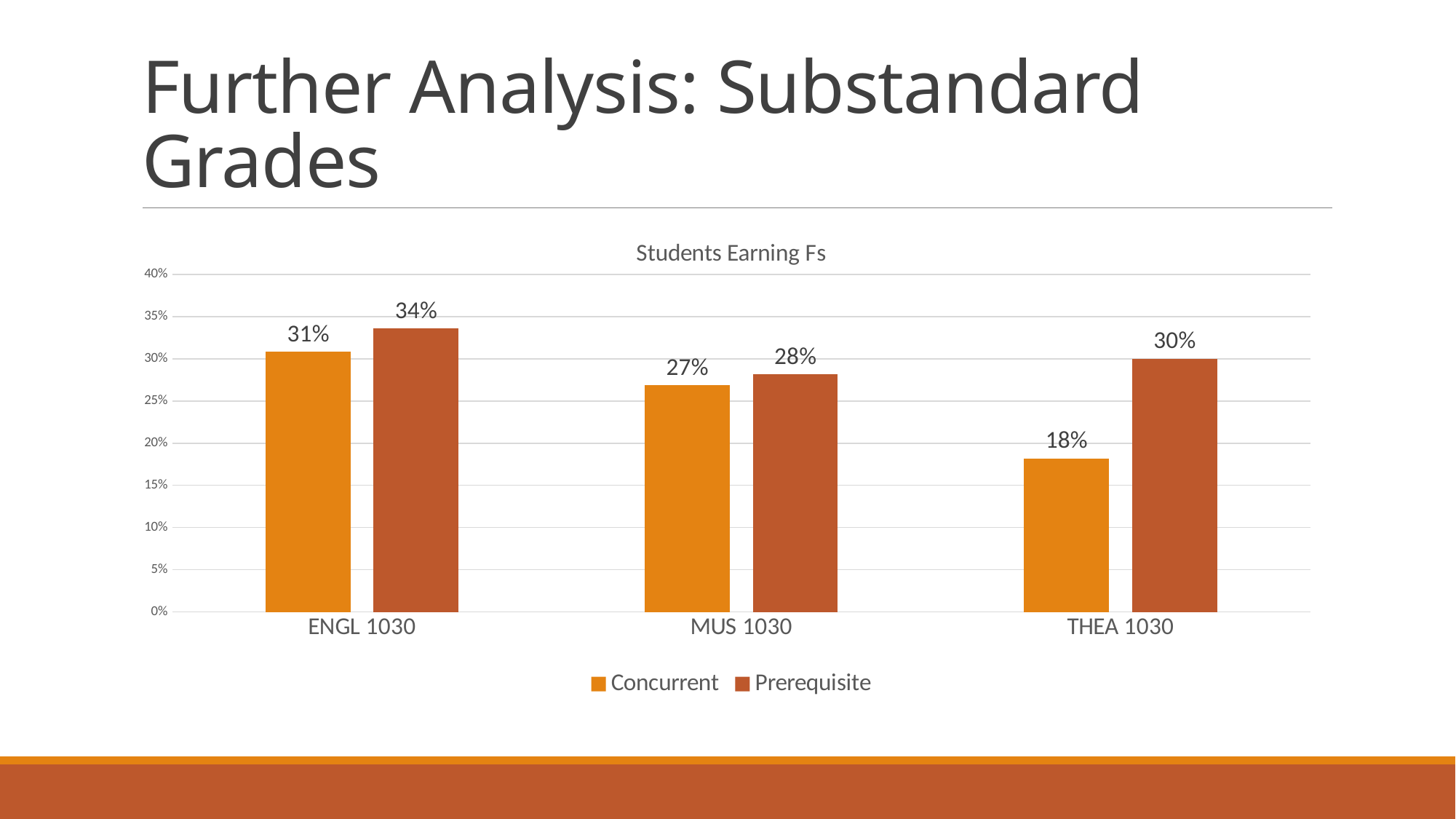
What is the difference between the Prerequisite and Concurrent values for ENGL 1030? 3% What kind of chart is shown on the slide? Bar chart What is the title of the chart? Students Earning Fs How many series does the legend list? 2 Which is larger for THEA 1030, the Concurrent value or the Prerequisite value? Prerequisite Which course has the lowest Concurrent value? THEA 1030 How many courses are shown on the x axis? 3 What is the Prerequisite value for THEA 1030? 30% What is the Concurrent value for MUS 1030? 27% What is the Concurrent value for ENGL 1030? 31% What is the difference between the Prerequisite and Concurrent values for THEA 1030? 12% Which course has the highest Prerequisite value? ENGL 1030